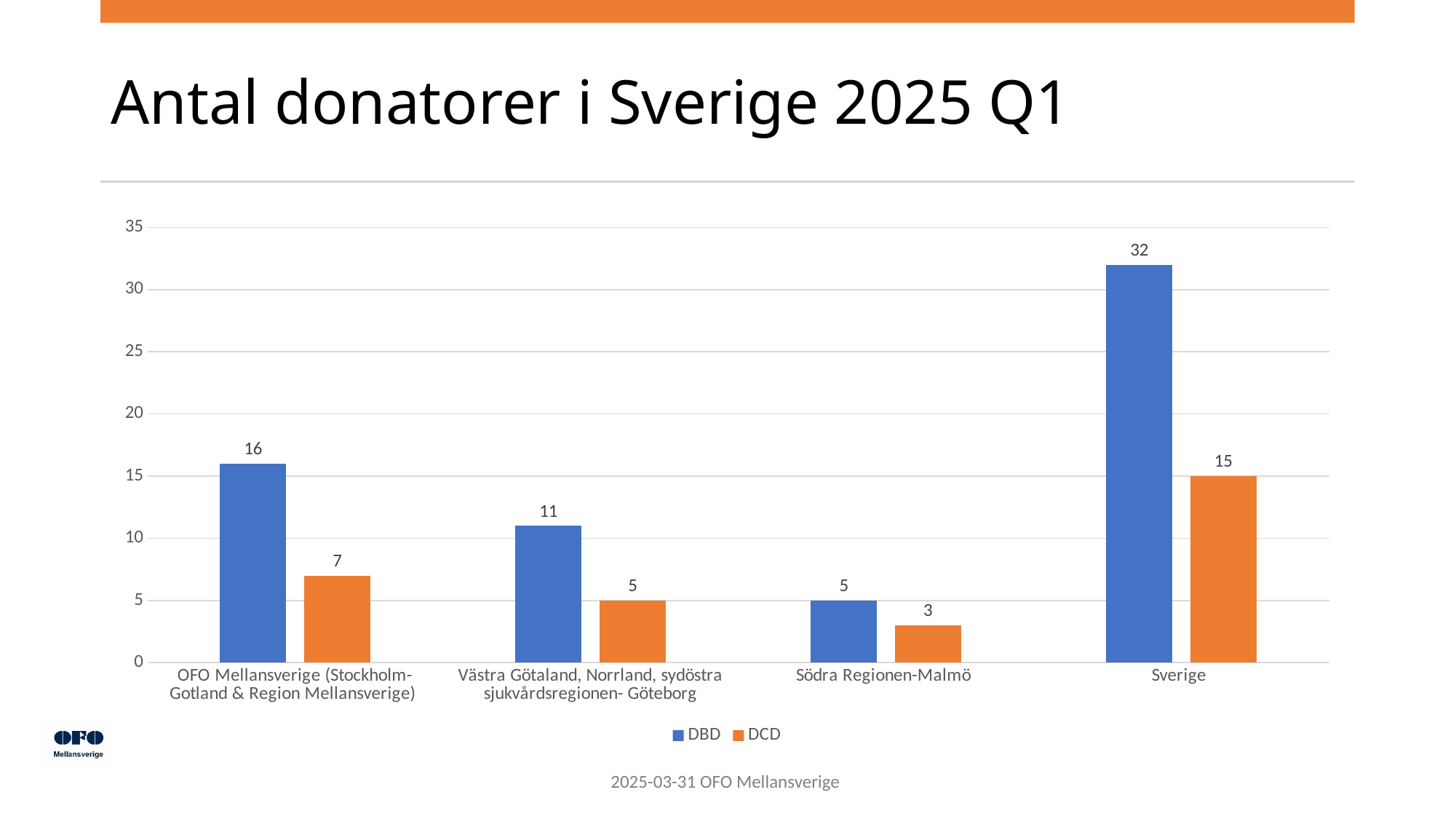
What is the DCD value for Södra Regionen-Malmö? 3 What is the difference between the DBD and DCD values for OFO Mellansverige (Stockholm-Gotland & Region Mellansverige)? 9 Is the DBD value for Sverige greater or less than 30? greater Which category has the lowest DBD value? Södra Regionen-Malmö What is the DBD value for Sverige? 32 What is the DCD value for Västra Götaland, Norrland, sydöstra sjukvårdsregionen- Göteborg? 5 Which is larger: the DBD value for Västra Götaland, Norrland, sydöstra sjukvårdsregionen- Göteborg or the DCD value for Sverige? DCD value for Sverige What is the DBD value for OFO Mellansverige (Stockholm-Gotland & Region Mellansverige)? 16 Which category has the highest DCD value? Sverige What kind of chart is shown on the slide? bar chart How many series does the legend list? 2 How many categories are shown on the x axis? 4